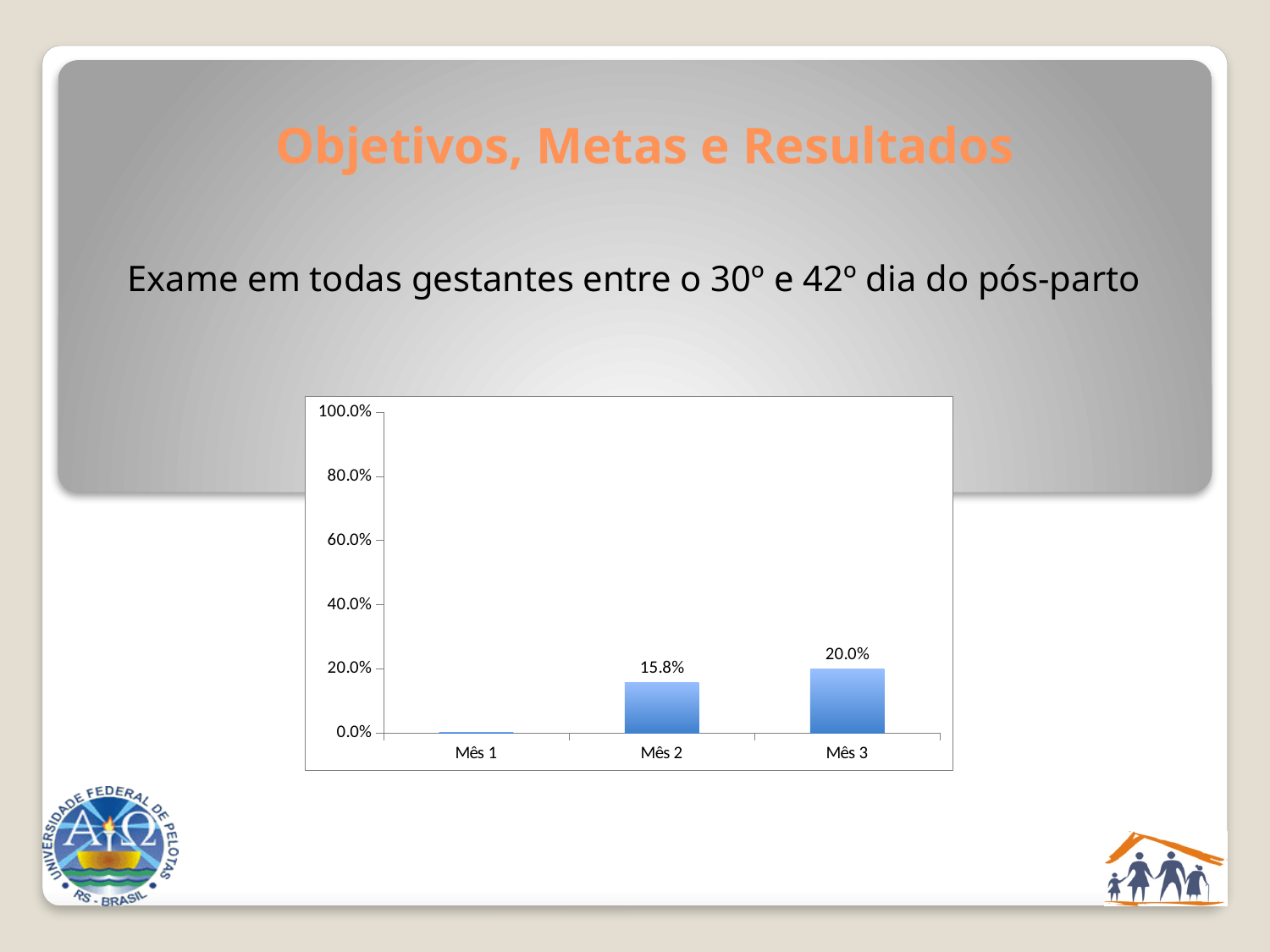
Do the values rise or fall from Mês 1 to Mês 3? rise Is the value for Mês 1 greater or less than 20.0%? less Is the value for Mês 3 greater or less than 40.0%? less What kind of chart is shown on the slide? bar chart Which month has the highest value? Mês 3 What is the value for Mês 2? 15.8% What is the difference between the values for Mês 3 and Mês 2? 4.2% What is the value for Mês 3? 20.0% Which month has the lowest value? Mês 1 What is the highest value shown on the y axis? 100.0% How many months are shown on the x axis? 3 Which is larger, the value for Mês 2 or the value for Mês 3? Mês 3